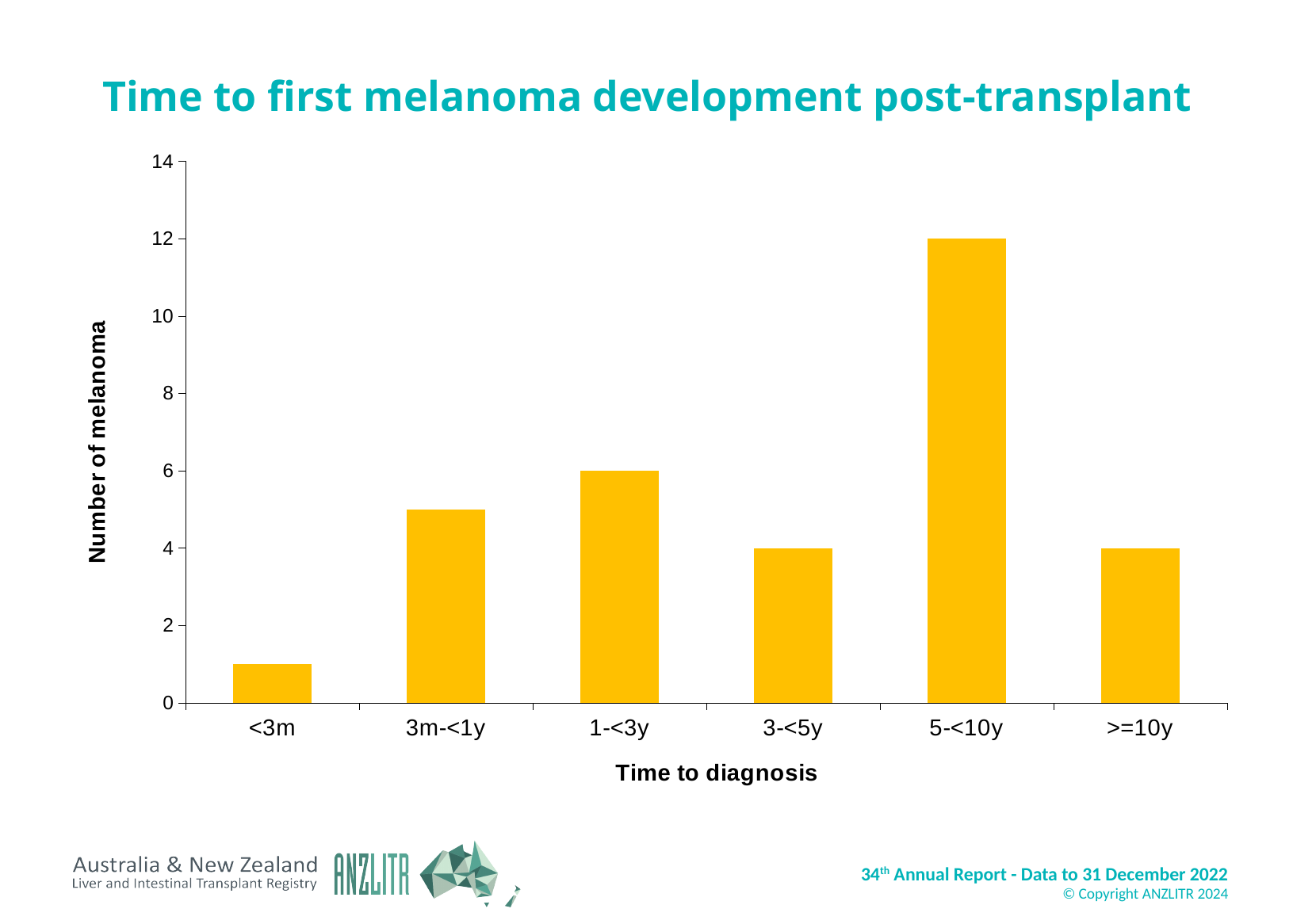
Which has a larger number of melanoma, the 5-<10y category or the >=10y category? 5-<10y Which time-to-diagnosis category has the highest number of melanoma? 5-<10y What is the number of melanoma for the 3-<5y category? 4 Which time-to-diagnosis category has the lowest number of melanoma? <3m What is the difference in number of melanoma between the 5-<10y and 1-<3y categories? 6 Is the number of melanoma for the 3m-<1y category greater or less than 4? greater Is the number of melanoma for the <3m category greater or less than 2? less How many time-to-diagnosis categories are shown on the x axis? 6 What kind of chart is shown on the slide? bar chart What is the number of melanoma for the 1-<3y category? 6 What is the label of the y axis? Number of melanoma What is the number of melanoma for the 5-<10y category? 12